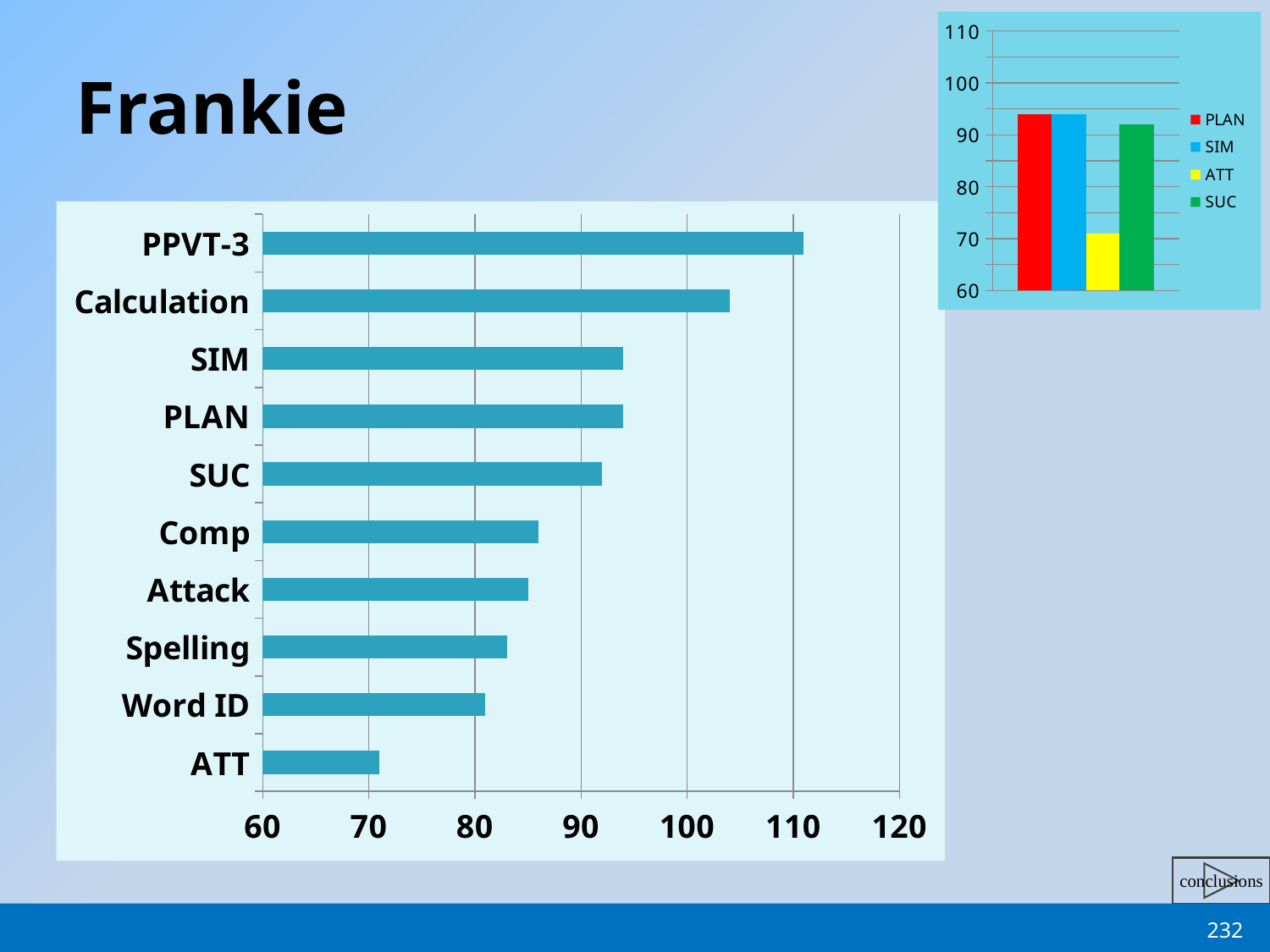
In the small chart at the top right, what colour is the ATT bar? yellow In the large bar chart on the left, which is larger, the value for Calculation or the value for Spelling? Calculation In the large bar chart on the left, is the value for ATT greater or less than 80? less In the large bar chart on the left, how many categories are plotted? 10 What kind of chart is the large chart on the left? bar chart In the large bar chart on the left, which is larger, the value for Word ID or the value for SUC? SUC In the large bar chart on the left, which category has the shortest bar? ATT In the large bar chart on the left, is the value for Calculation greater or less than 100? greater In the large bar chart on the left, which category has the longest bar? PPVT-3 In the large bar chart on the left, is the value for Comp greater or less than 90? less In the small chart at the top right, which series has the lowest value? ATT In the small chart at the top right, how many series does the legend list? 4